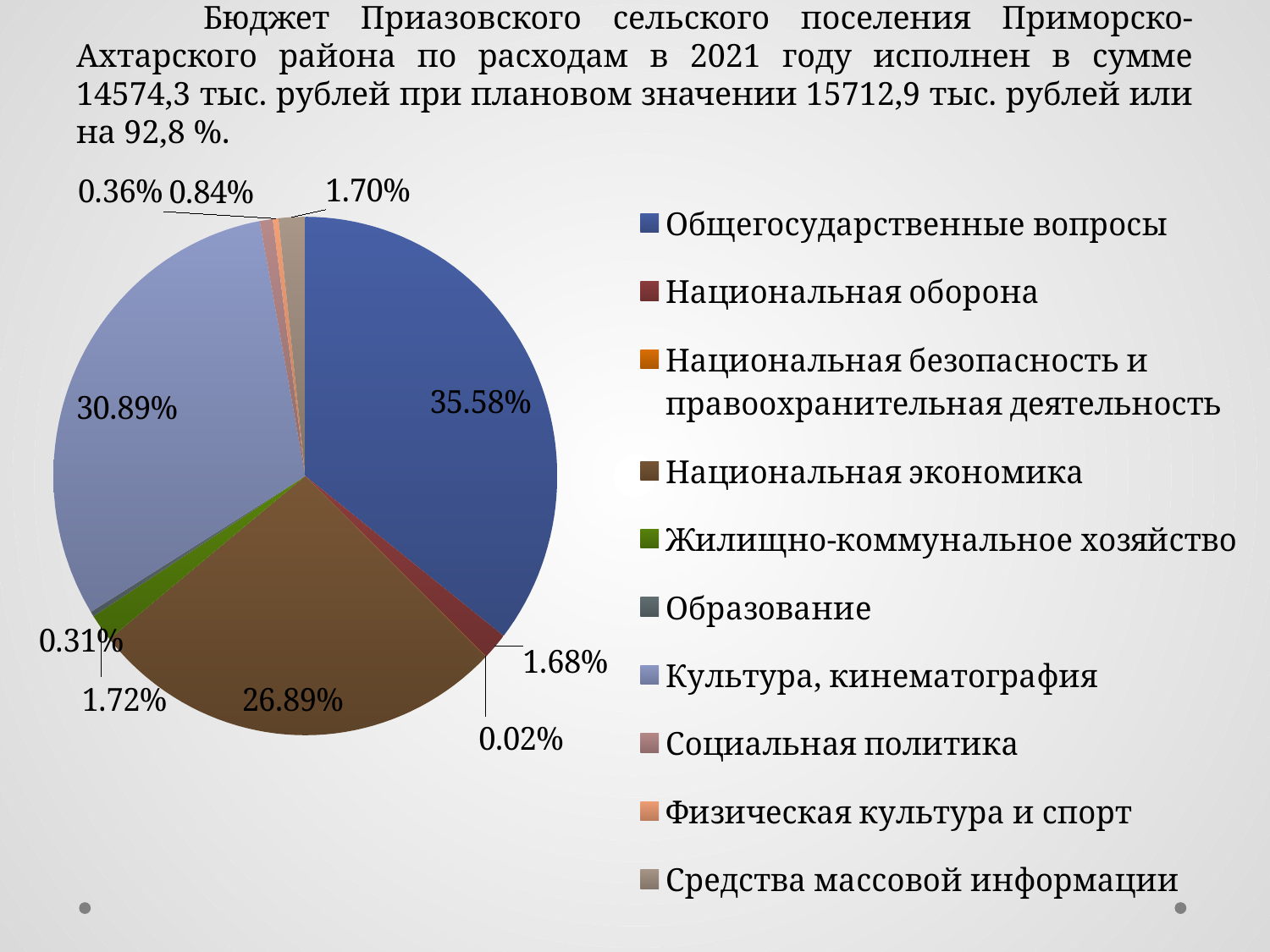
What kind of chart is shown on the slide? pie chart Which category has the largest slice of the pie? Общегосударственные вопросы What share of the pie does Национальная экономика have? 26.89% What is the difference between the shares of Общегосударственные вопросы and Культура, кинематография? 4.69% What is the value shown for Жилищно-коммунальное хозяйство? 1.72% What share of the pie does Общегосударственные вопросы have? 35.58% What share of the pie does Культура, кинематография have? 30.89% What is the value shown for Средства массовой информации? 1.70% Which category has the smallest slice of the pie? Национальная безопасность и правоохранительная деятельность How many categories does the legend of the pie chart list? 10 Which is larger, the share for Национальная экономика or the share for Культура, кинематография? Культура, кинематография What is the value shown for Национальная оборона? 1.68%